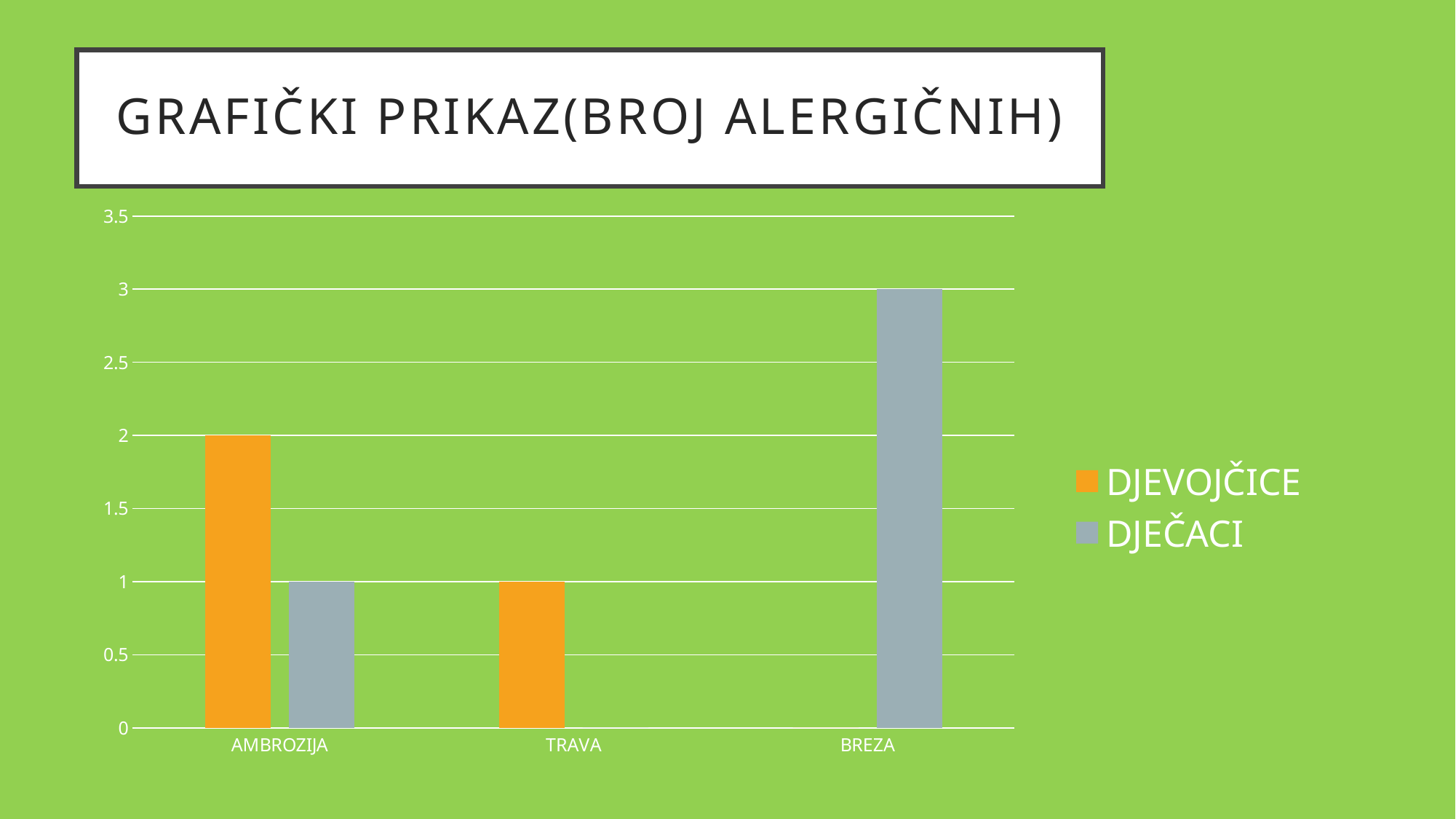
How many series does the legend list? 2 Which category has the highest value for DJEVOJČICE? AMBROZIJA What is the difference between the DJEČACI value for BREZA and the DJEČACI value for AMBROZIJA? 2 What is the value for DJEVOJČICE in the AMBROZIJA category? 2 What is the value for DJEVOJČICE in the TRAVA category? 1 What is the value for DJEČACI in the BREZA category? 3 What is the value for DJEČACI in the AMBROZIJA category? 1 In the AMBROZIJA category, which series has the larger value, DJEVOJČICE or DJEČACI? DJEVOJČICE Which colour represents the DJEČACI series in the legend? grey What kind of chart is shown on the slide? bar chart Which category has the highest value for DJEČACI? BREZA How many categories are shown on the x axis? 3